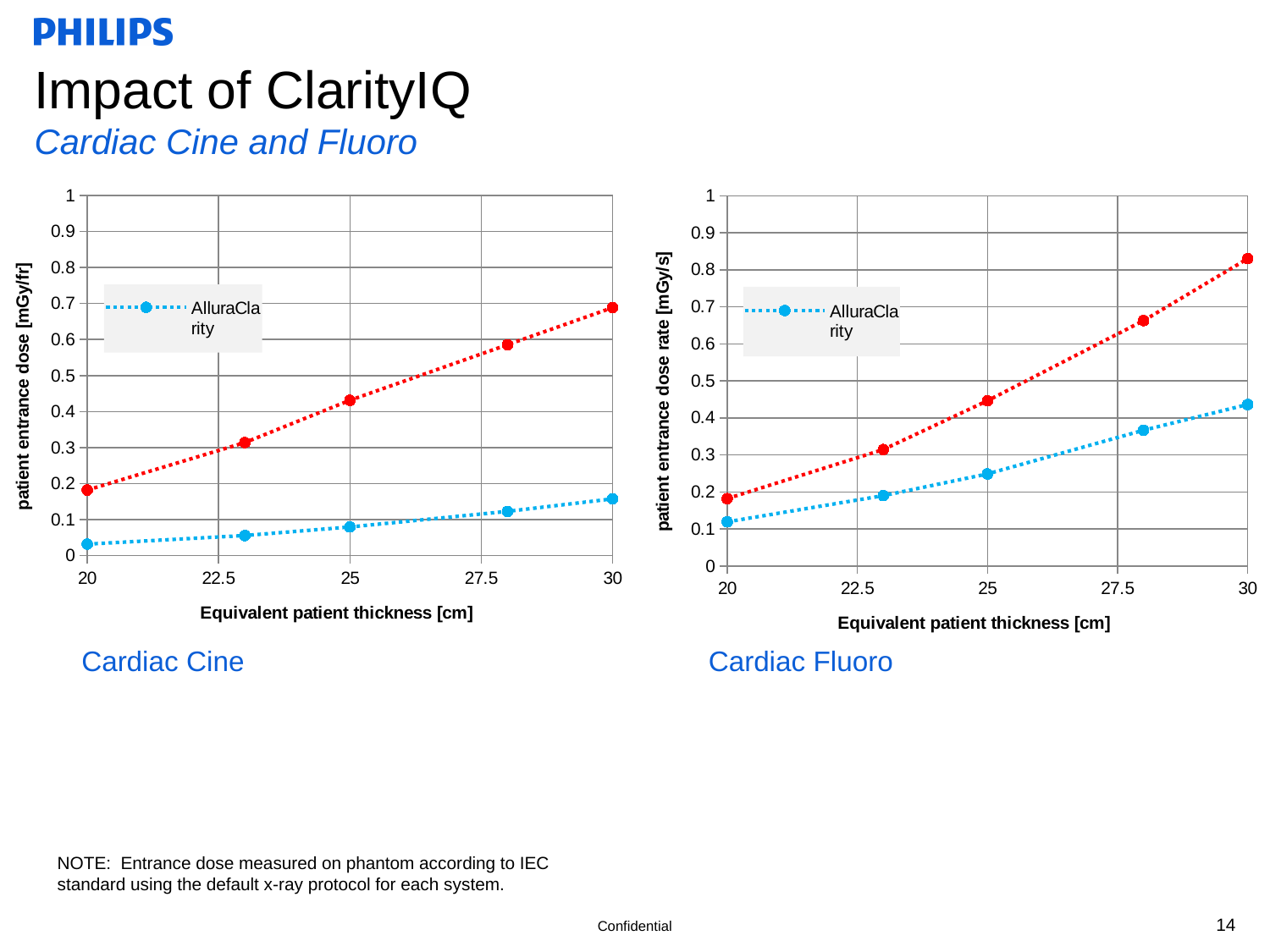
In the Cardiac Fluoro chart, does the AlluraClarity line rise or fall as equivalent patient thickness increases? rise What type of chart is the Cardiac Cine chart on the left? line chart In the Cardiac Cine chart, at 30 cm, which line has the higher value: the red dotted line or the AlluraClarity line? the red dotted line In the Cardiac Cine chart, is the AlluraClarity value at 30 cm greater or less than 0.2? less In the Cardiac Cine chart, is the red dotted line's value at 30 cm greater or less than 0.6? greater At 30 cm, is the AlluraClarity value larger in the Cardiac Cine chart or in the Cardiac Fluoro chart? Cardiac Fluoro How many series does the legend of the Cardiac Fluoro chart list? 1 In the Cardiac Fluoro chart, is the AlluraClarity value at 25 cm greater or less than 0.3? less What is the y-axis title of the Cardiac Fluoro chart? patient entrance dose rate [mGy/s] In the Cardiac Fluoro chart, at which equivalent patient thickness is the AlluraClarity value highest? 30 In the Cardiac Cine chart, how many data points does the AlluraClarity series have? 5